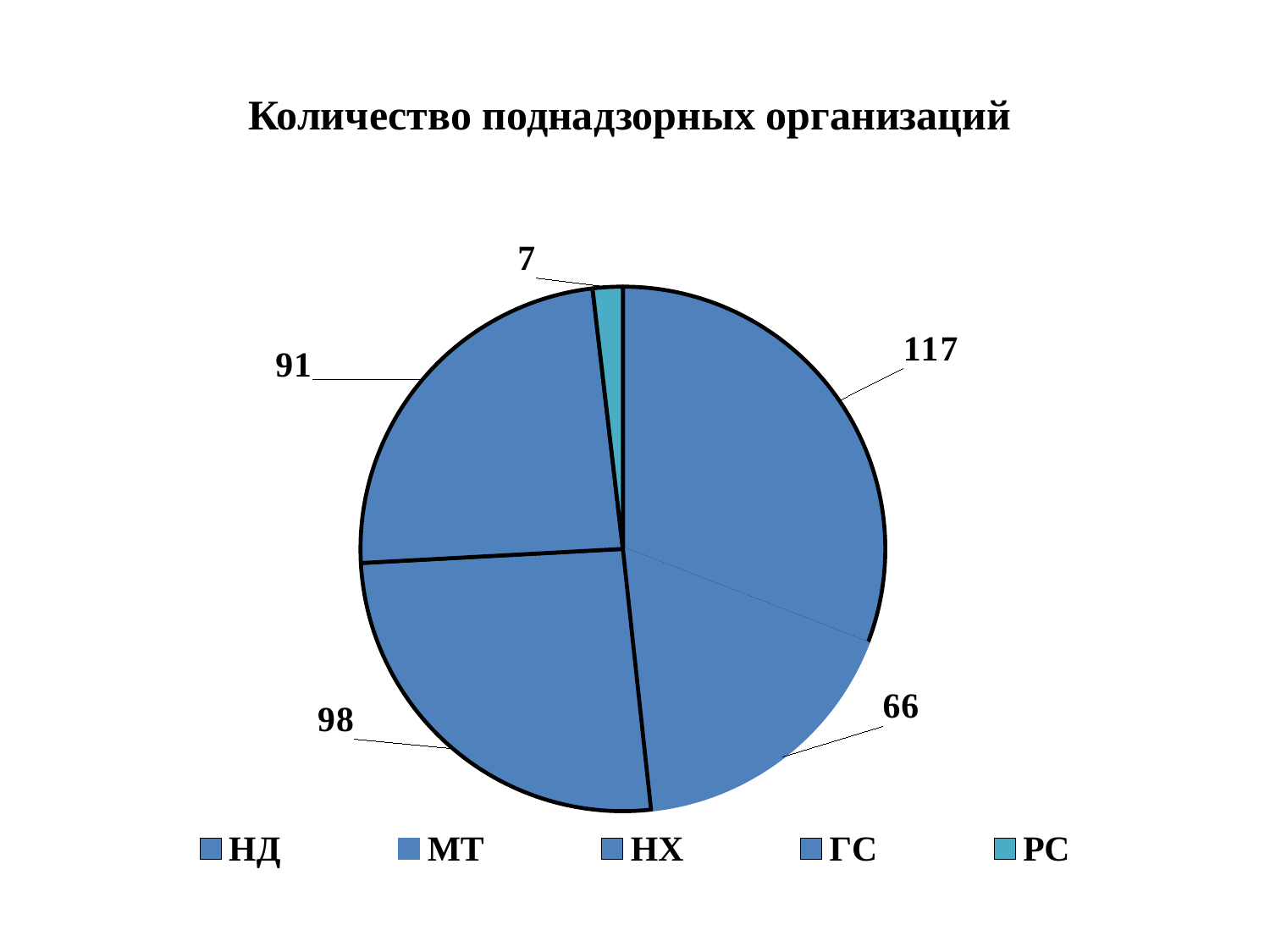
Which is larger, the slice labelled 91 or the slice labelled 66? 91 What is the value of the РС slice? 7 What is the title of the chart? Количество поднадзорных организаций How many entries does the legend list? 5 What is the total of all the values shown on the pie chart? 379 Which legend category has the smallest slice? РС What is the difference between the largest slice (117) and the slice labelled 98? 19 Which legend category is drawn in a different (teal) colour from the other slices? РС What is the largest value shown on the pie chart? 117 How many slices does the pie chart have? 5 What kind of chart is shown on the slide? Pie chart What is the difference between the slices labelled 98 and 91? 7